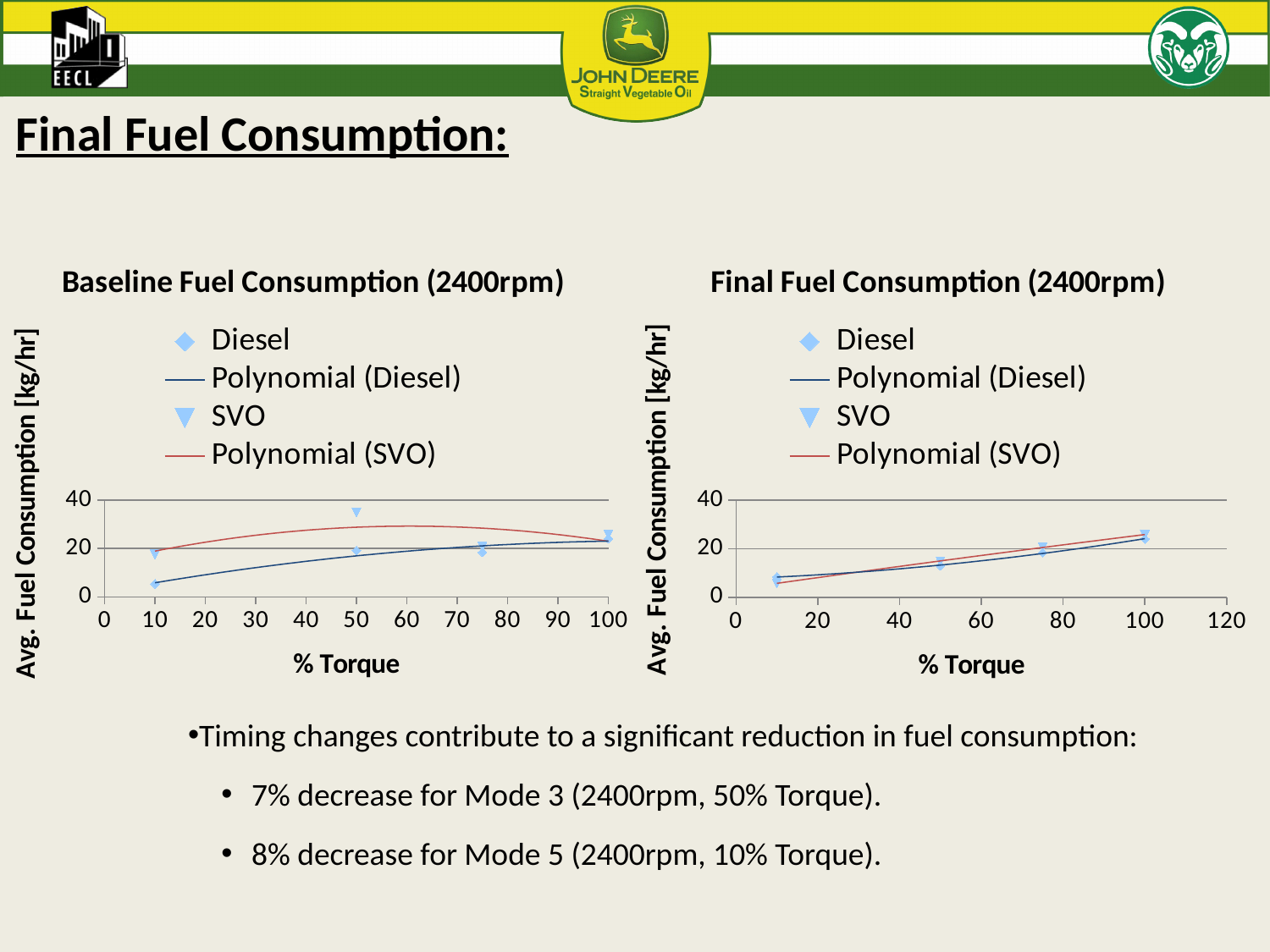
In the Final Fuel Consumption (2400rpm) chart, do the Diesel values rise or fall as % Torque increases? rise In the Baseline Fuel Consumption (2400rpm) chart, is the SVO value at 50% torque greater or less than 20? greater In the Baseline Fuel Consumption (2400rpm) chart, is the Diesel value at 10% torque greater or less than 20? less What is the y-axis label of the Final Fuel Consumption (2400rpm) chart? Avg. Fuel Consumption [kg/hr] In the Final Fuel Consumption (2400rpm) chart, is the SVO value at 10% torque greater or less than 20? less How many series does the legend of the Final Fuel Consumption (2400rpm) chart list? 4 What kind of chart is the Baseline Fuel Consumption (2400rpm) chart? scatter chart What is the x-axis label of the Baseline Fuel Consumption (2400rpm) chart? % Torque How many Diesel data points are plotted in the Final Fuel Consumption (2400rpm) chart? 4 In the Baseline Fuel Consumption (2400rpm) chart, which is larger at 50% torque, the SVO value or the Diesel value? SVO In the Baseline Fuel Consumption (2400rpm) chart, which is larger at 10% torque, the SVO value or the Diesel value? SVO